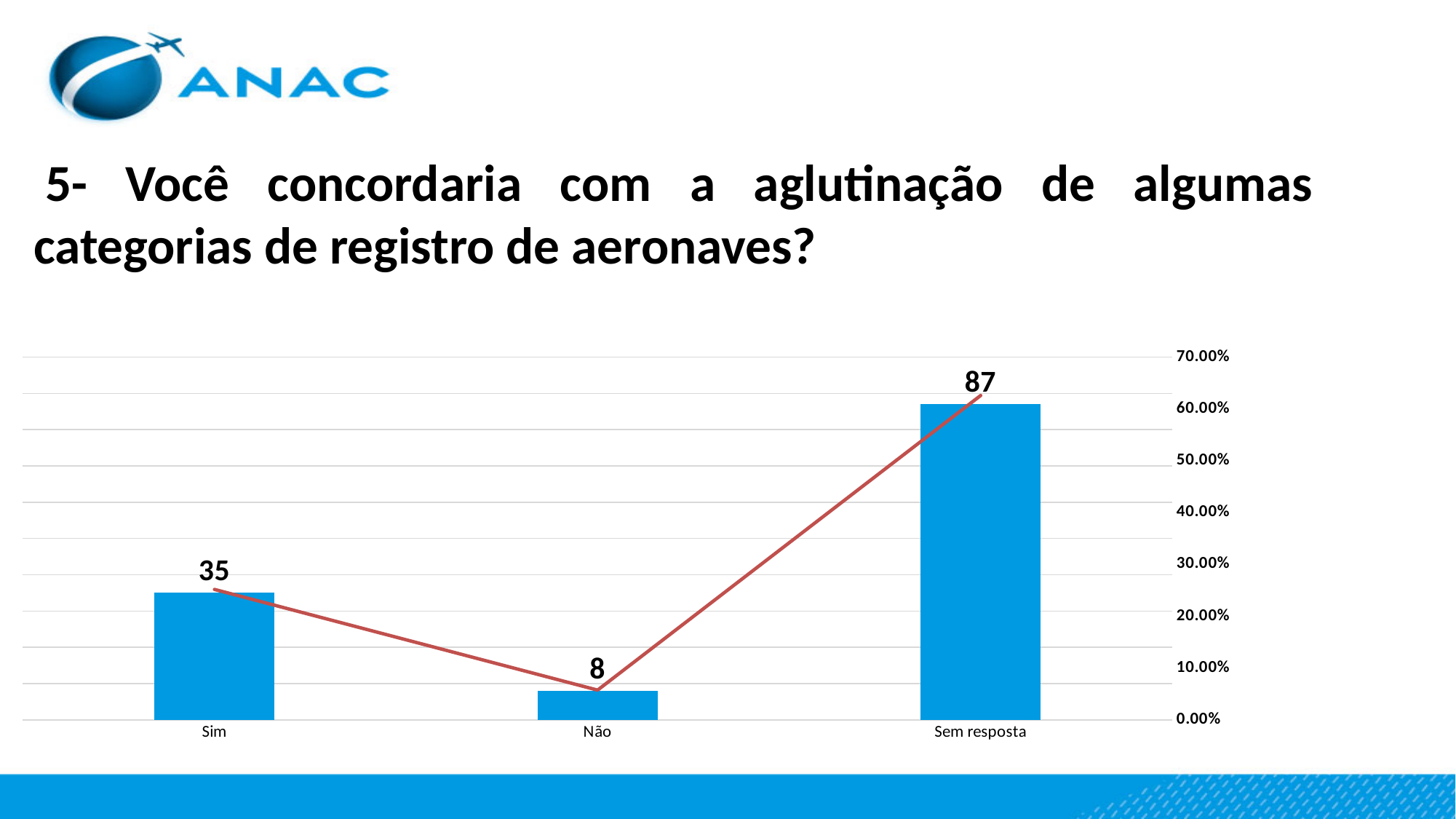
What is the highest tick value shown on the right-hand axis? 70.00% What is the value shown for "Sim"? 35 Which is larger, the value for "Sim" or the value for "Não"? Sim What is the difference between the values for "Sem resposta" and "Sim"? 52 How many categories are shown on the x axis? 3 What is the value shown for "Sem resposta"? 87 Which category has the lowest value? Não What colour are the bars in the chart? Blue What is the difference between the values for "Sim" and "Não"? 27 Which category has the highest value? Sem resposta What is the value shown for "Não"? 8 What kind of chart is shown on the slide? Bar chart with a line overlay